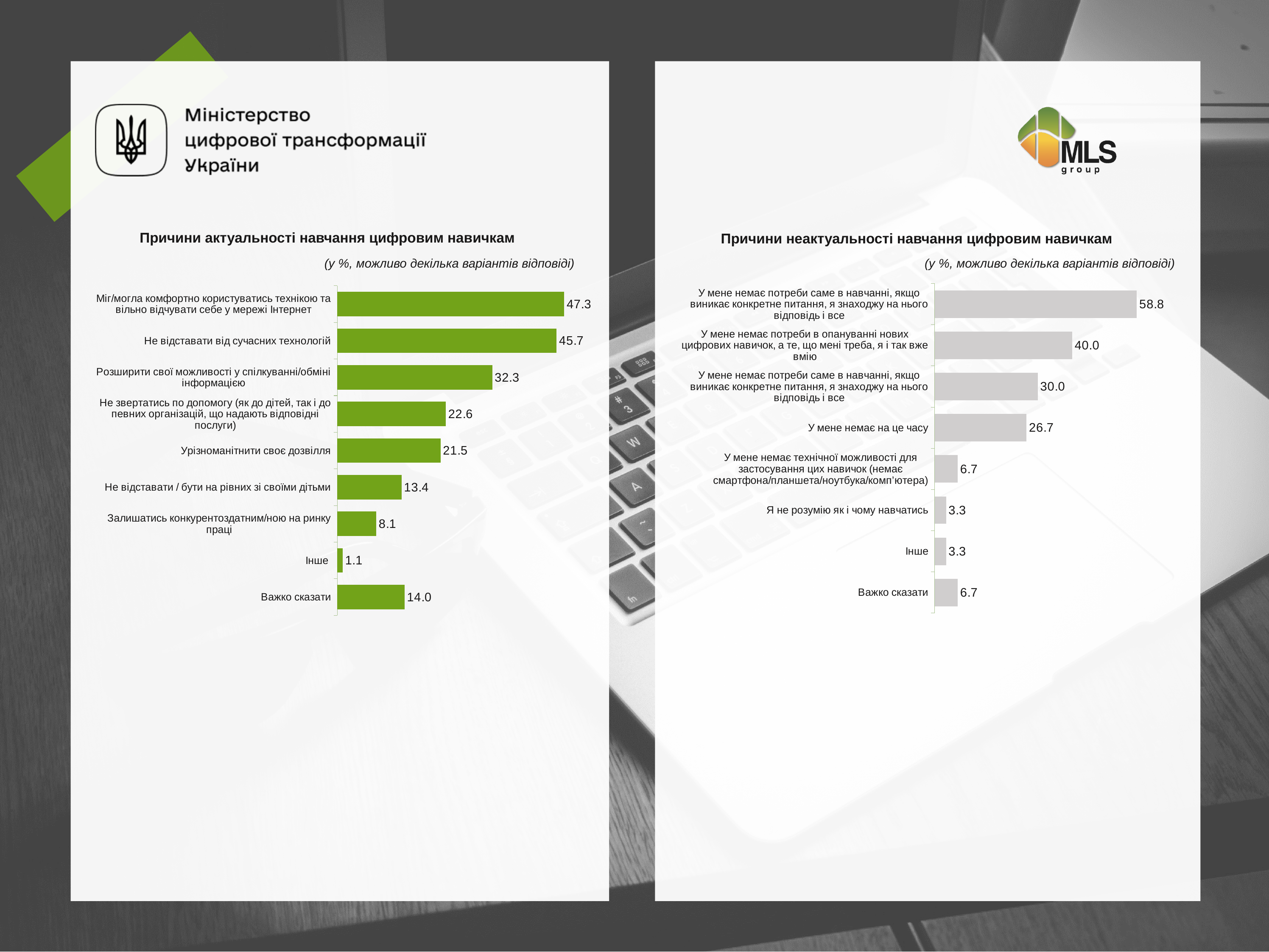
In the chart 'Причини неактуальності навчання цифровим навичкам', which is larger: 'У мене немає на це часу' or 'Я не розумію як і чому навчатись'? У мене немає на це часу In the chart 'Причини актуальності навчання цифровим навичкам', which category has the highest value? Міг/могла комфортно користуватись технікою та вільно відчувати себе у мережі Інтернет In the chart 'Причини неактуальності навчання цифровим навичкам', what is the highest value shown? 58.8 How many categories are shown in the chart 'Причини актуальності навчання цифровим навичкам'? 9 In the chart 'Причини актуальності навчання цифровим навичкам', what is the difference between 'Важко сказати' and 'Залишатись конкурентоздатним/ною на ринку праці'? 5.9 In the chart 'Причини актуальності навчання цифровим навичкам', what is the value for 'Урізноманітнити своє дозвілля'? 21.5 In the chart 'Причини актуальності навчання цифровим навичкам', which category has the lowest value? Інше In the chart 'Причини неактуальності навчання цифровим навичкам', what is the value for 'У мене немає на це часу'? 26.7 In the chart 'Причини актуальності навчання цифровим навичкам', what is the value for 'Не відставати від сучасних технологій'? 45.7 In the chart 'Причини неактуальності навчання цифровим навичкам', what is the value for 'У мене немає потреби в опануванні нових цифрових навичок, а те, що мені треба, я і так вже вмію'? 40.0 How many categories are shown in the chart 'Причини неактуальності навчання цифровим навичкам'? 8 What type of chart is 'Причини неактуальності навчання цифровим навичкам'? Bar chart